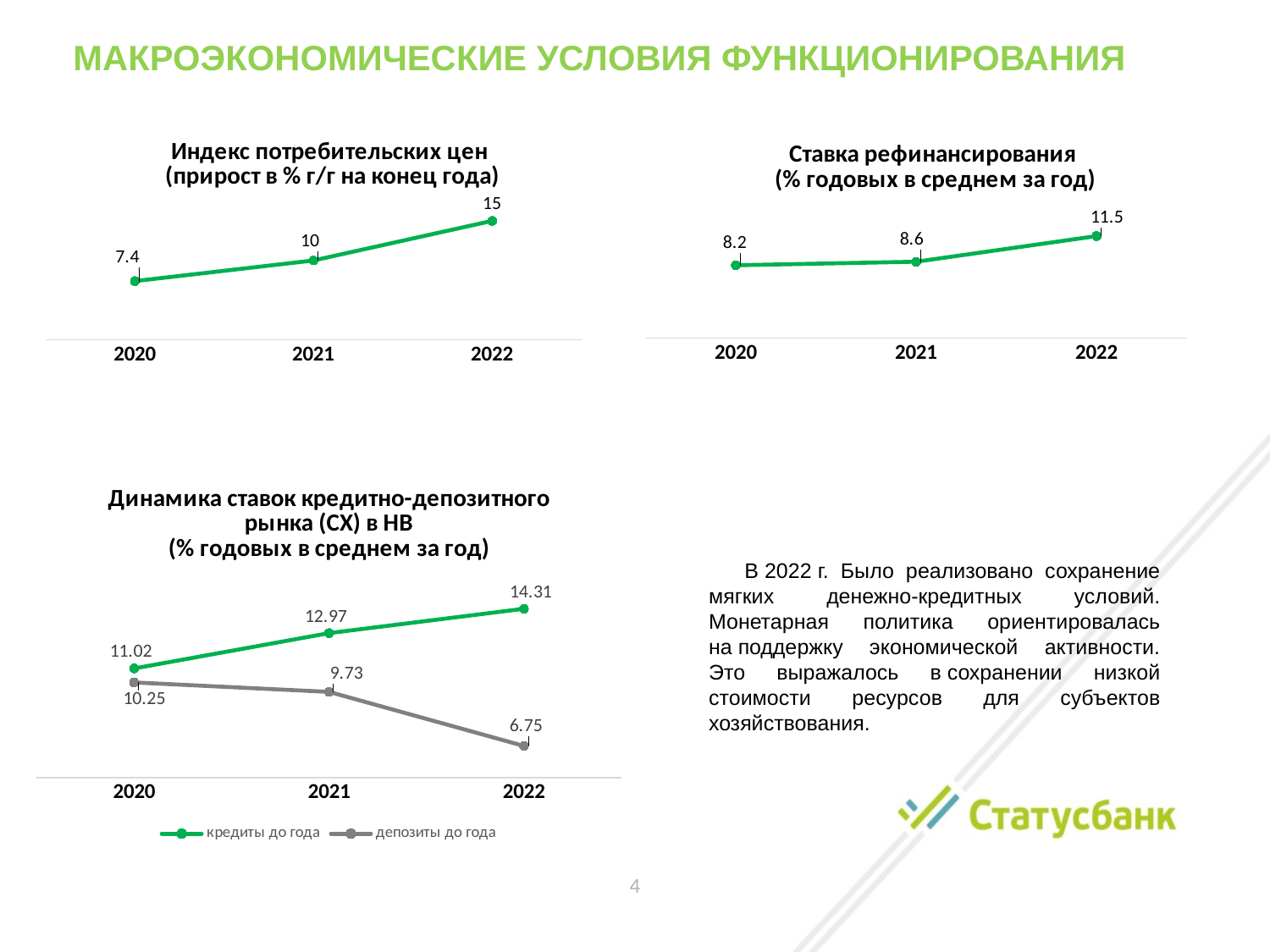
In the chart 'Динамика ставок кредитно-депозитного рынка', what is the value for 'кредиты до года' in 2021? 12.97 In the chart 'Ставка рефинансирования', do the values rise or fall from 2020 to 2022? rise In the chart 'Индекс потребительских цен', which year has the lowest value? 2020 In the chart 'Динамика ставок кредитно-депозитного рынка', how many series does the legend list? 2 In the chart 'Динамика ставок кредитно-депозитного рынка', do the values for 'депозиты до года' rise or fall from 2020 to 2022? fall What kind of chart is 'Ставка рефинансирования'? line chart In the chart 'Индекс потребительских цен', what is the difference between the 2022 and 2020 values? 7.6 In the chart 'Динамика ставок кредитно-депозитного рынка', what is the difference between 'кредиты до года' and 'депозиты до года' in 2022? 7.56 In the chart 'Динамика ставок кредитно-депозитного рынка', what is the value for 'депозиты до года' in 2022? 6.75 In the chart 'Индекс потребительских цен', what is the value for 2022? 15 In the chart 'Ставка рефинансирования', which year has the highest value? 2022 In the chart 'Ставка рефинансирования', what is the value for 2021? 8.6